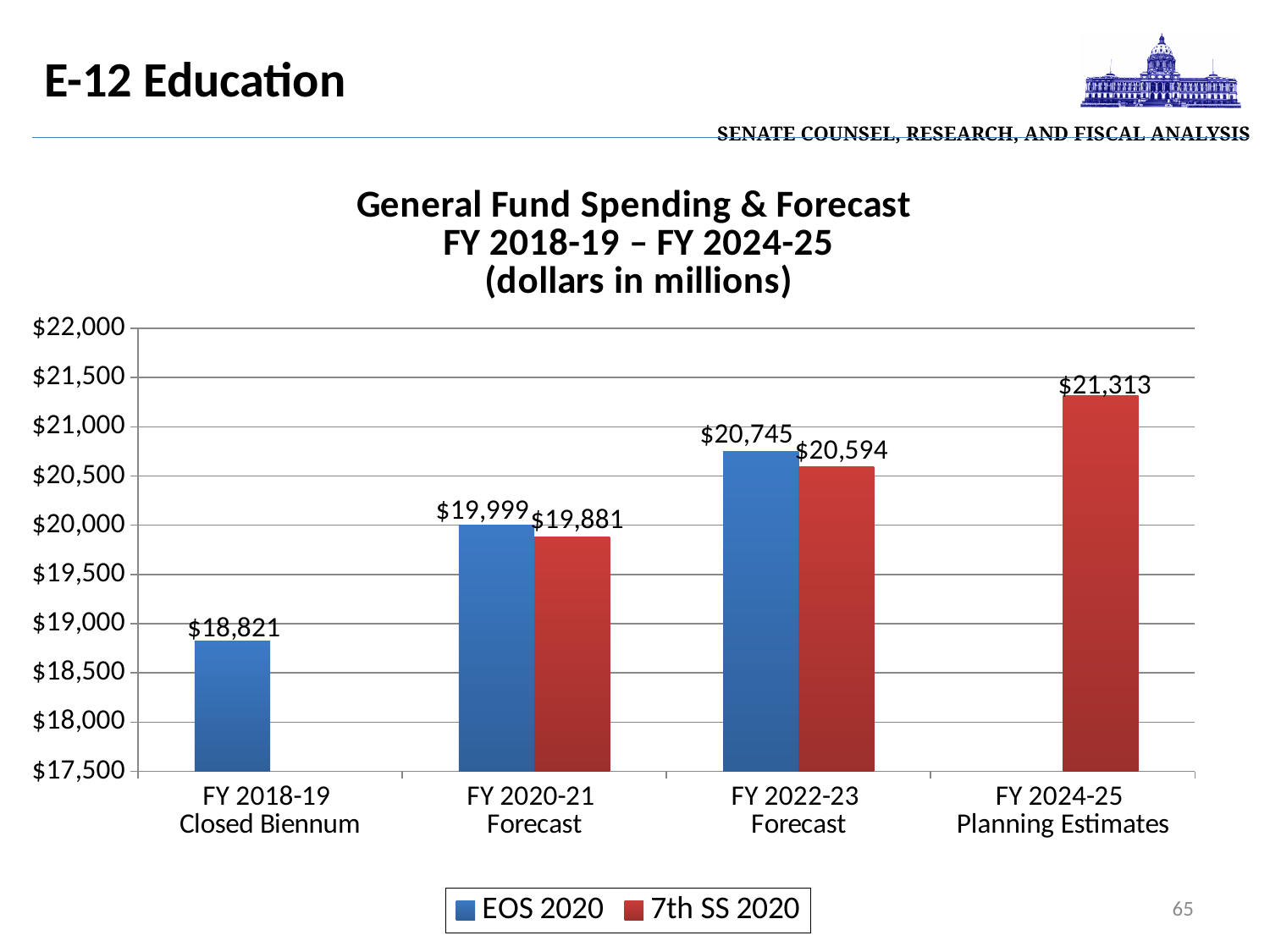
What is the EOS 2020 value for FY 2018-19 Closed Biennum? $18,821 How many series does the legend list? 2 Which category has the lowest EOS 2020 value? FY 2018-19 Closed Biennum Do the 7th SS 2020 values rise or fall from FY 2020-21 to FY 2024-25? Rise What is the EOS 2020 value for FY 2022-23 Forecast? $20,745 How many fiscal year categories are shown on the x axis? 4 What is the 7th SS 2020 value for FY 2020-21 Forecast? $19,881 What is the difference between the EOS 2020 and 7th SS 2020 values for FY 2022-23 Forecast? $151 What is the 7th SS 2020 value for FY 2024-25 Planning Estimates? $21,313 What kind of chart is shown on the slide? Bar chart For FY 2020-21 Forecast, which is larger: the EOS 2020 value or the 7th SS 2020 value? EOS 2020 Which category has the highest 7th SS 2020 value? FY 2024-25 Planning Estimates